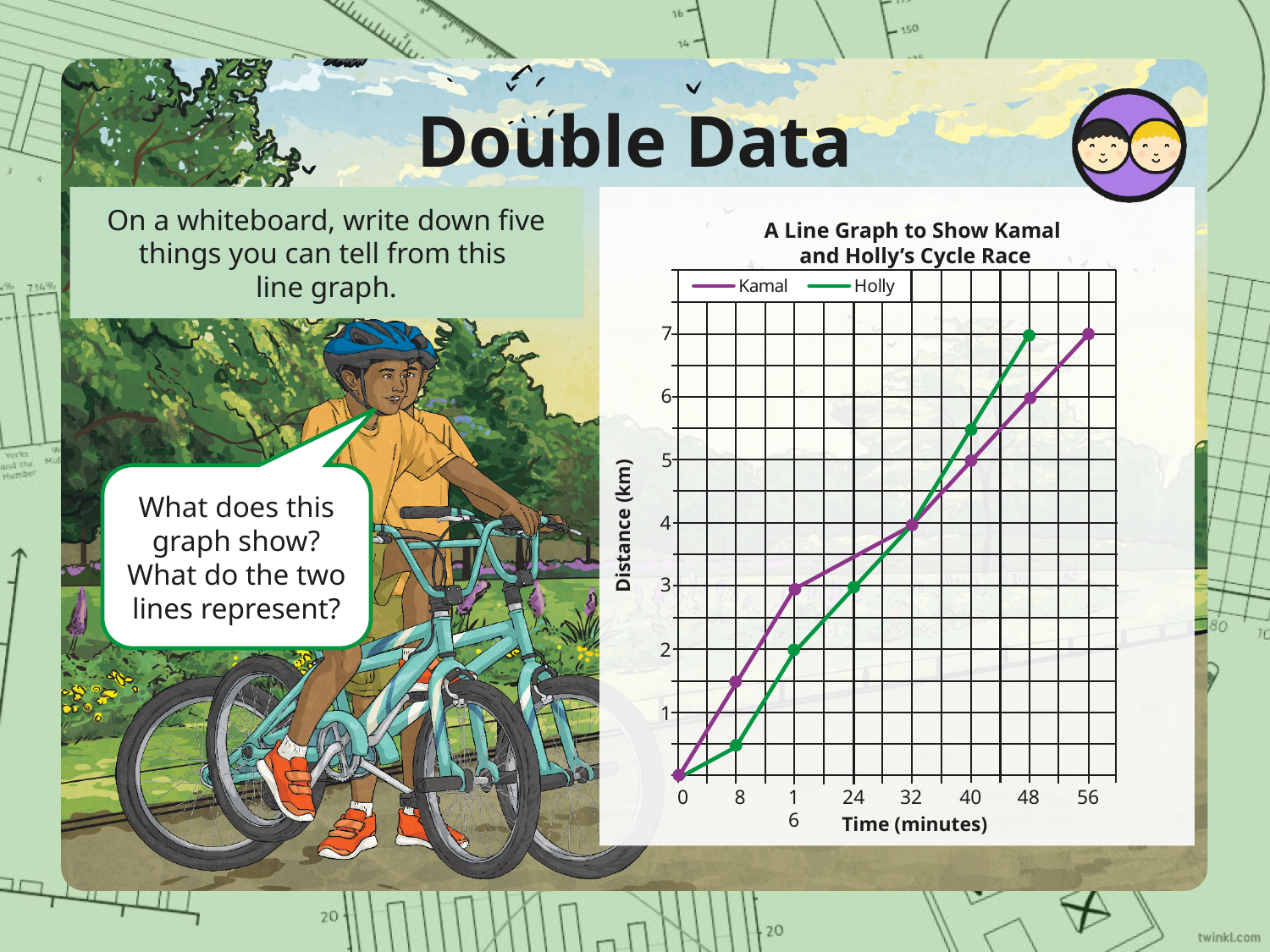
Do the distances for both riders rise or fall as time increases? Rise Is Holly's distance at 8 minutes greater or less than 1 km? less What is the difference between Kamal's and Holly's distances at 16 minutes? 1 km What kind of chart is shown on the slide? Line chart After how many minutes did Holly reach 7 km? 48 At 40 minutes, who had covered the greater distance, Kamal or Holly? Holly What distance had Holly covered after 24 minutes? 3 km Is Kamal's distance at 8 minutes greater or less than 1 km? greater What distance had Kamal covered after 16 minutes? 3 km How many series does the legend list? 2 What is the title of the chart? A Line Graph to Show Kamal and Holly's Cycle Race At 8 minutes, who had covered the greater distance, Kamal or Holly? Kamal